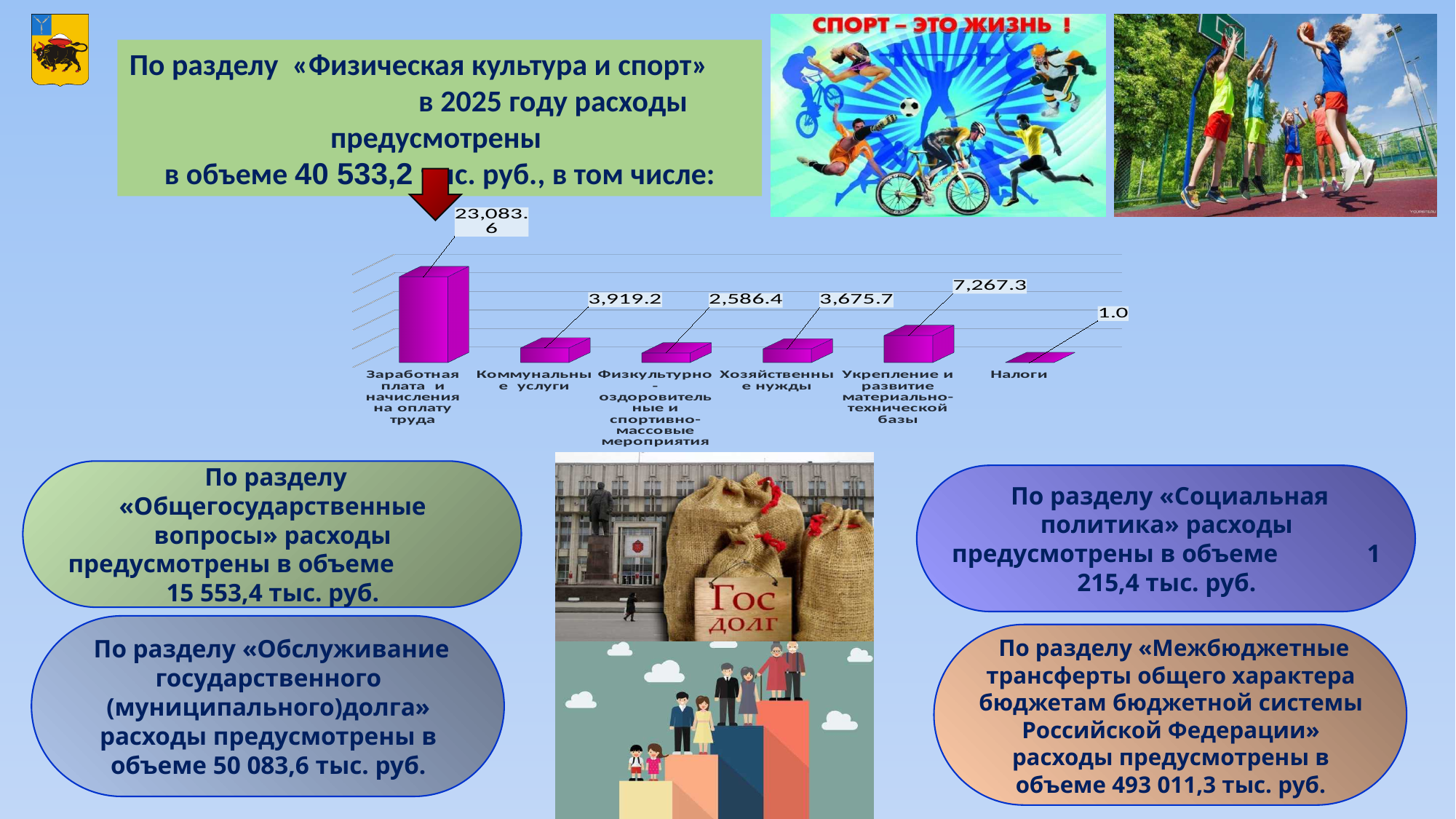
What is the value for «Физкультурно-оздоровительные и спортивно-массовые мероприятия»? 2,586.4 What kind of chart is shown on the slide? Bar chart What is the value for «Коммунальные услуги»? 3,919.2 What is the value for «Налоги»? 1.0 What is the difference between «Коммунальные услуги» and «Физкультурно-оздоровительные и спортивно-массовые мероприятия»? 1,332.8 What is the value for «Укрепление и развитие материально-технической базы»? 7,267.3 How many categories are shown in the chart? 6 Which category has the lowest value? Налоги What is the difference between «Заработная плата и начисления на оплату труда» and «Укрепление и развитие материально-технической базы»? 15,816.3 Which category has the highest value? Заработная плата и начисления на оплату труда Which is larger: «Коммунальные услуги» or «Хозяйственные нужды»? Коммунальные услуги What is the value for «Заработная плата и начисления на оплату труда»? 23,083.6